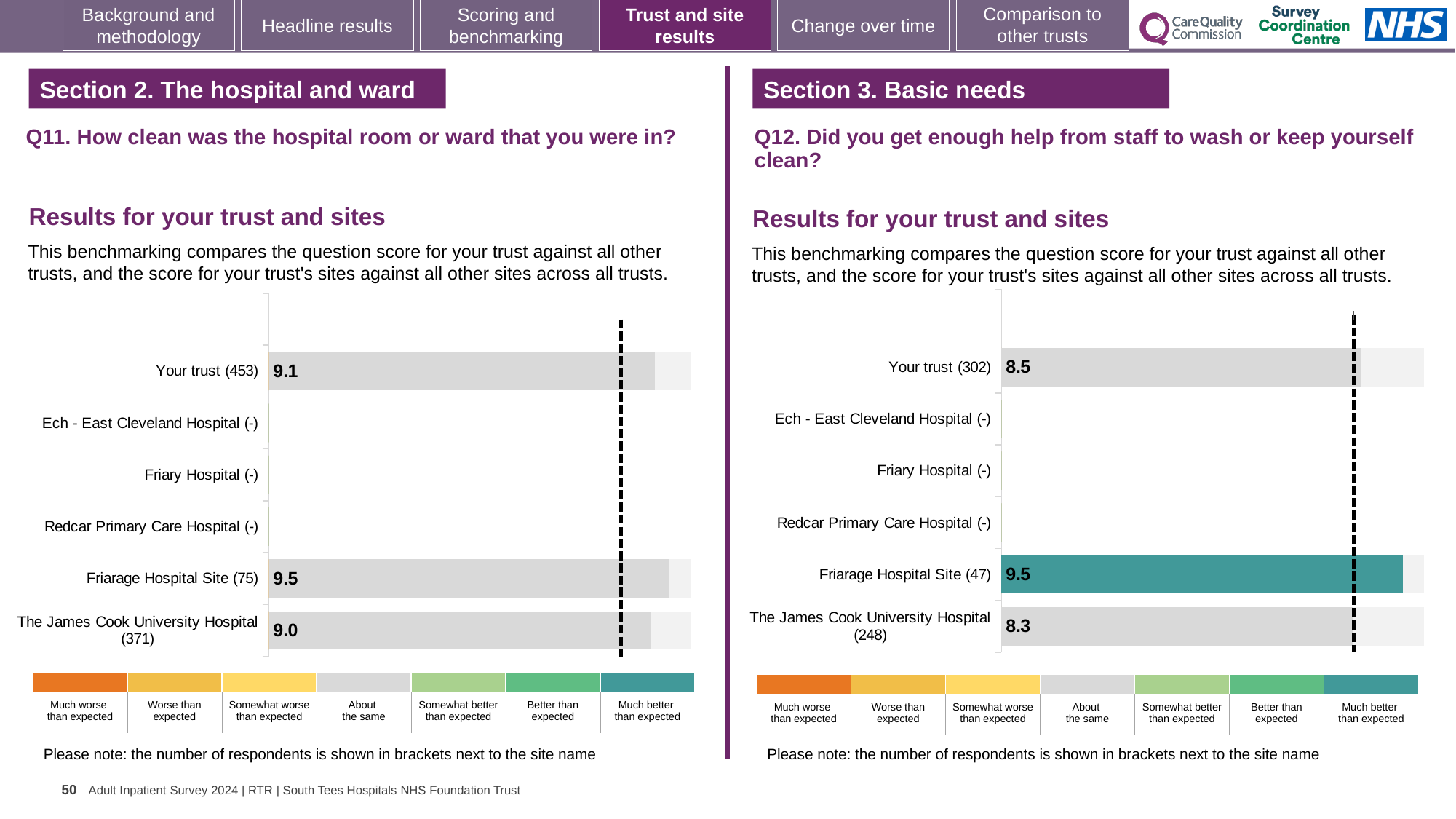
In the Q12 chart on the right, which is larger: the score for Your trust or the score for The James Cook University Hospital? Your trust In the Q12 chart on the right, what is the score for Your trust (302)? 8.5 In the Q11 chart on the left, what is the score for Friarage Hospital Site (75)? 9.5 In the Q11 chart on the left, what is the score for Your trust (453)? 9.1 In the Q12 chart on the right, what is the difference between the Friarage Hospital Site score and the Your trust score? 1.0 In the Q11 chart on the left, what is the score for The James Cook University Hospital (371)? 9.0 In the Q12 chart on the right, what is the score for The James Cook University Hospital (248)? 8.3 In the Q12 chart on the right, which benchmark category does the colour of the Friarage Hospital Site bar correspond to? Much better than expected In the Q11 chart on the left, which site has the highest score? Friarage Hospital Site (75) In the Q11 chart on the left, what is the difference between the Friarage Hospital Site score and The James Cook University Hospital score? 0.5 In the Q12 chart on the right, which site has the lowest score among those with a value shown? The James Cook University Hospital (248) What type of chart is used in the Q11 chart on the left? Bar chart